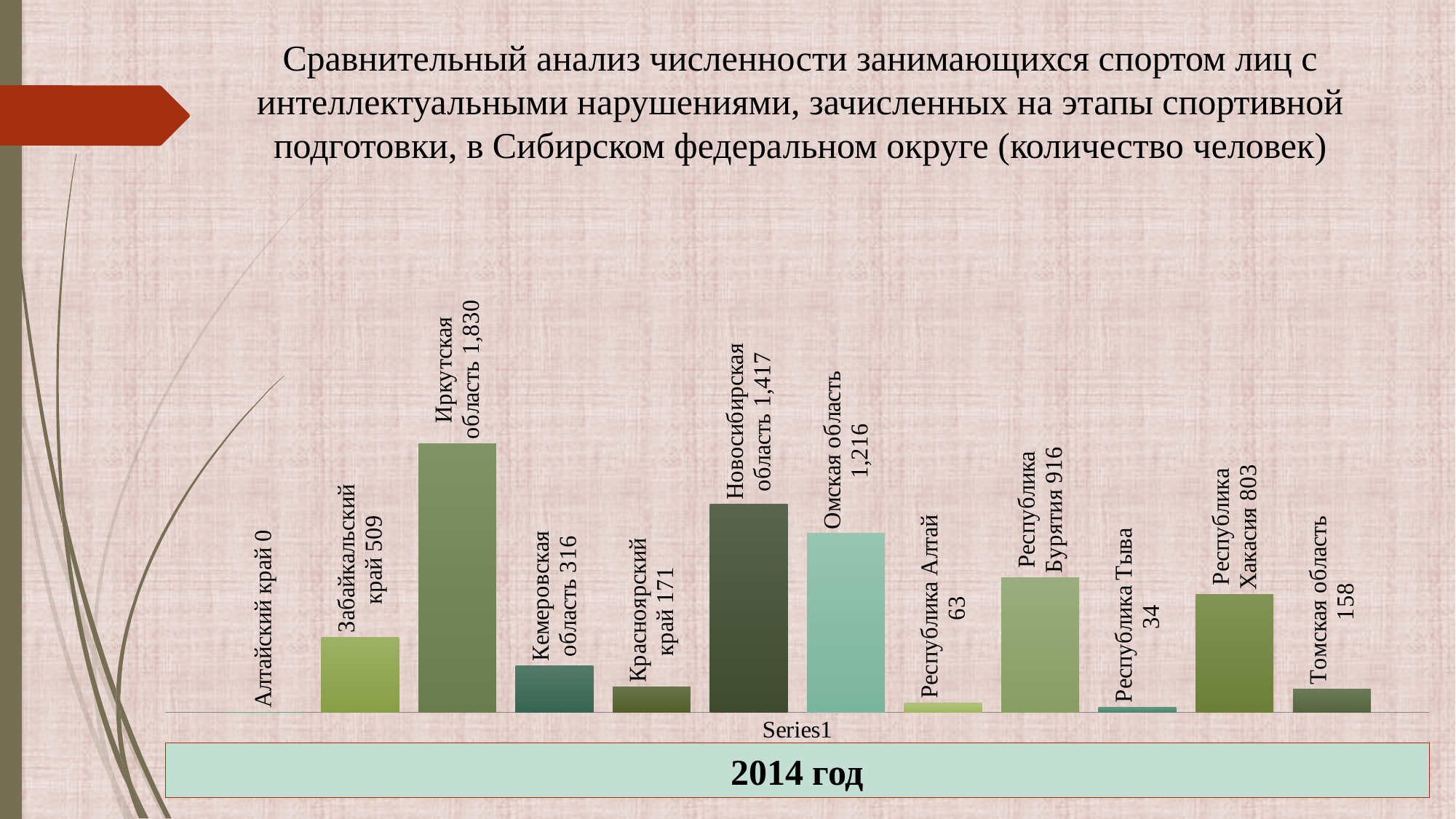
What is the difference between the values for Новосибирская область and Омская область? 201 Which region has the lowest value? Алтайский край Which year does the chart refer to, according to the label below it? 2014 год What is the value for Иркутская область? 1,830 What is the value for Алтайский край? 0 What is the value for Республика Бурятия? 916 Which region has the highest value? Иркутская область What kind of chart is shown on the slide? Bar chart Which is larger, the value for Республика Хакасия or the value for Республика Бурятия? Республика Бурятия How many regions are shown in the chart? 12 What is the value for Томская область? 158 What is the difference between the values for Забайкальский край and Кемеровская область? 193